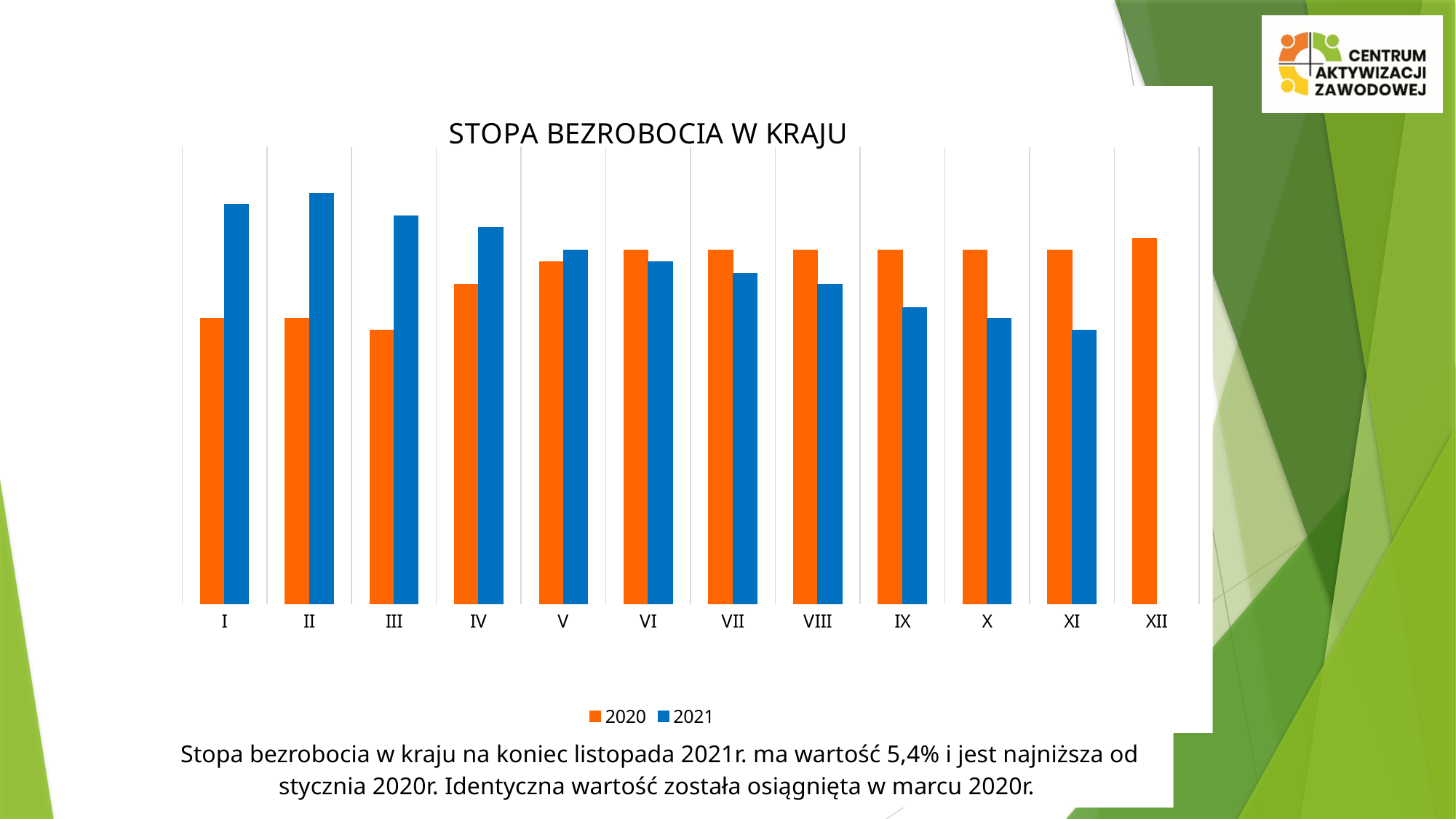
In month XI, which series has the larger value, 2020 or 2021? 2020 How many months (categories) are shown on the x axis? 12 In which month is the 2020 bar the highest? XII Which series is shown in blue? 2021 In which month is the 2021 bar the lowest? XI How many series does the legend list? 2 In which month is the 2020 bar the lowest? III In which month is the 2021 bar the highest? II Do the 2021 values generally rise or fall from month I to month XI? fall In month I, which series has the larger value, 2020 or 2021? 2021 What is the title of the chart? STOPA BEZROBOCIA W KRAJU What kind of chart is shown on the slide? bar chart